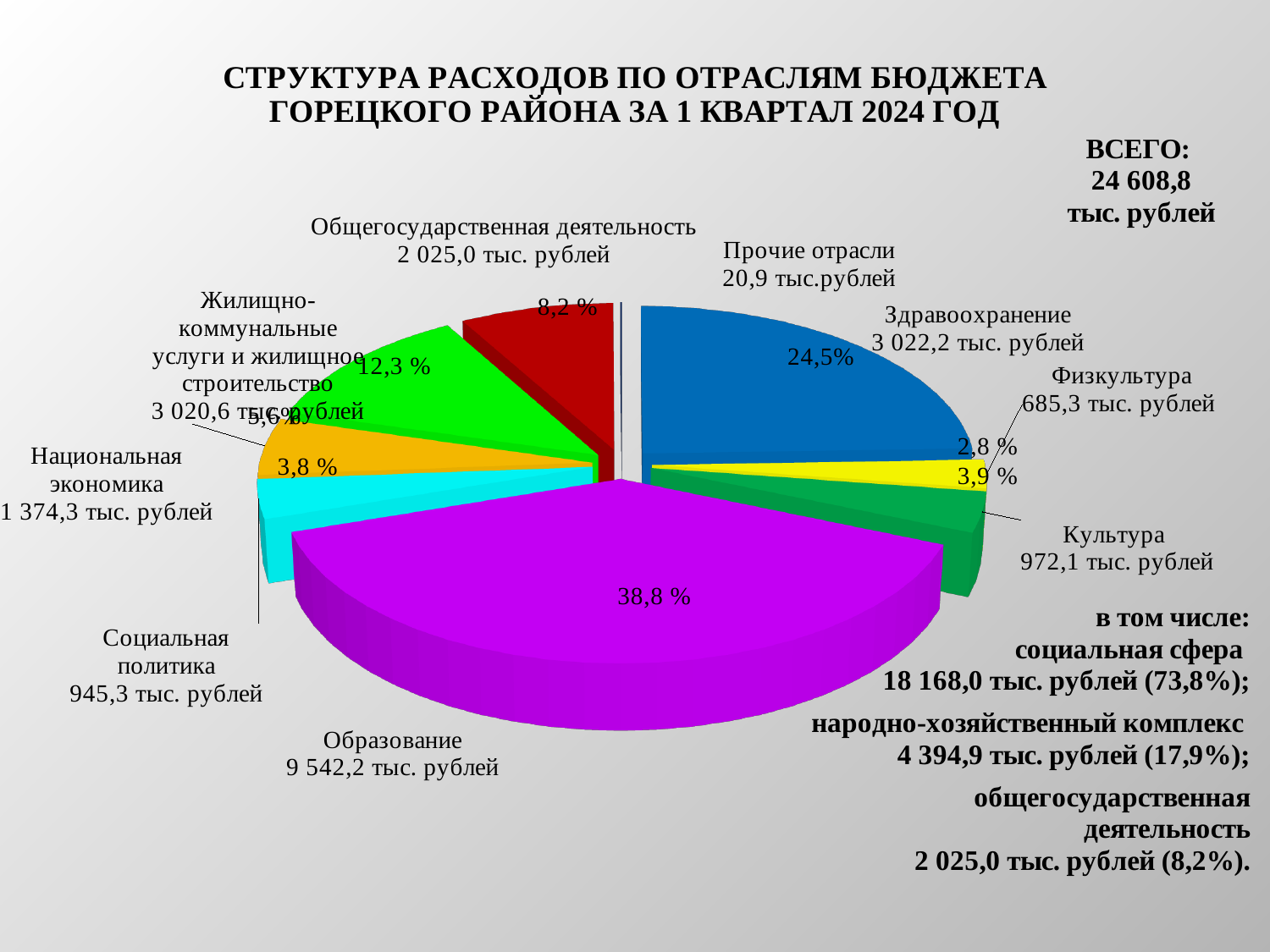
Which is larger, the expenditure for Культура or for Социальная политика? Культура What is the total expenditure (ВСЕГО) shown on the slide? 24 608,8 тыс. рублей What kind of chart is shown on the slide? pie chart What share of the pie does Образование account for? 38,8 % What is the expenditure value shown for Здравоохранение? 3 022,2 тыс. рублей Which sector has the largest slice of the pie? Образование What is the expenditure value shown for Образование? 9 542,2 тыс. рублей What is the difference between the expenditure for Образование and for Здравоохранение? 6 520,0 тыс. рублей What share of the pie does Общегосударственная деятельность account for? 8,2 % How many sectors are labelled on the pie chart? 9 What is the expenditure value shown for Физкультура? 685,3 тыс. рублей Which sector has the smallest expenditure value? Прочие отрасли